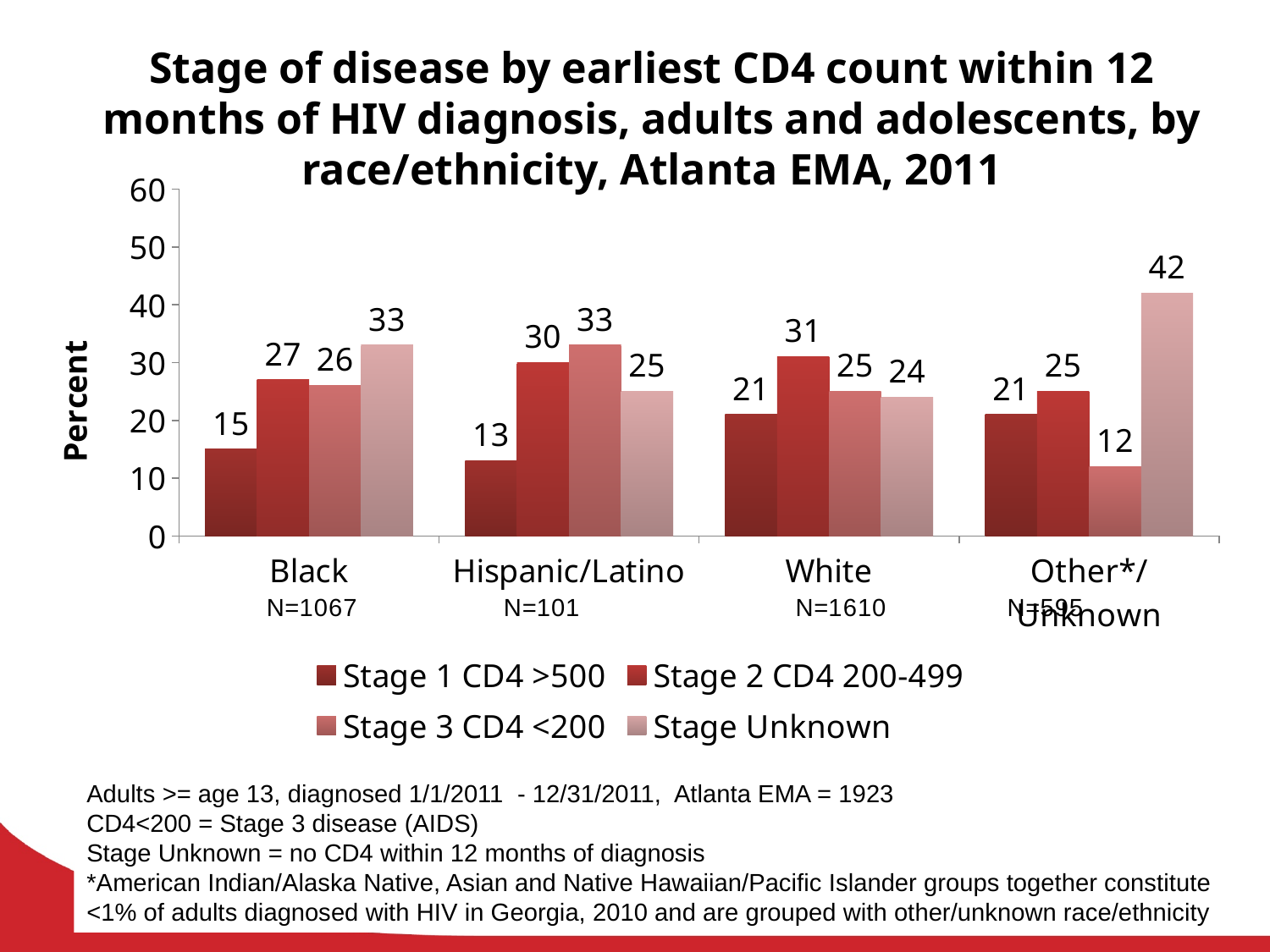
What is the difference between the Stage Unknown value and the Stage 3 CD4 <200 value for Other*/Unknown? 30 Which is larger for Black: the Stage 2 CD4 200-499 value or the Stage Unknown value? Stage Unknown What is the Stage 1 CD4 >500 value for Black? 15 What is the Stage Unknown value for Other*/Unknown? 42 How many race/ethnicity categories are shown on the x axis? 4 Which race/ethnicity group has the lowest Stage 1 CD4 >500 value? Hispanic/Latino What is the Stage 2 CD4 200-499 value for White? 31 How many series does the legend list? 4 Which race/ethnicity group has the highest Stage Unknown value? Other*/Unknown What is the Stage 3 CD4 <200 value for Hispanic/Latino? 33 What kind of chart is shown on the slide? Bar chart What is the label of the y axis? Percent